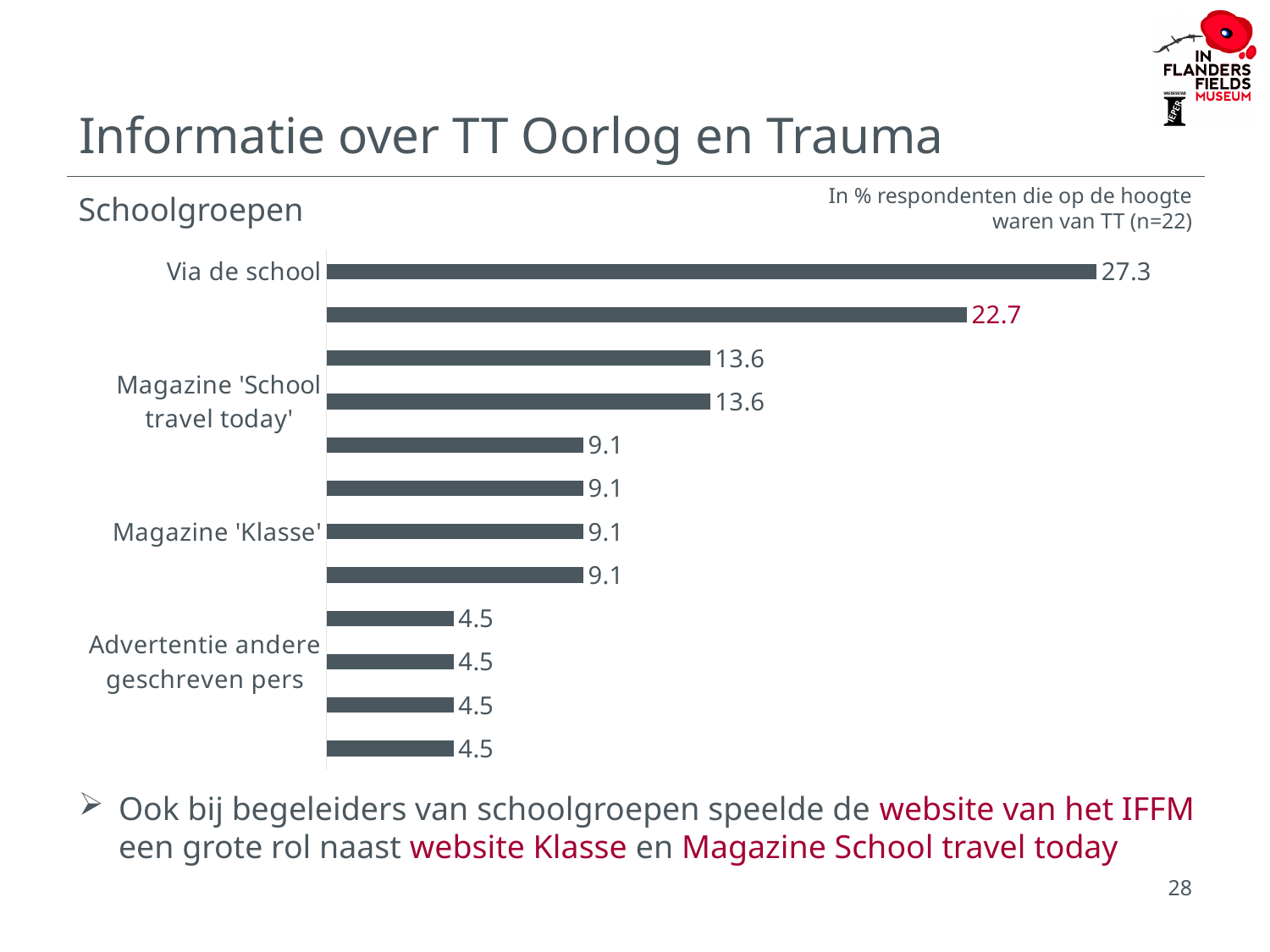
How many bars are plotted in the chart? 12 Which is larger, the value for Magazine 'School travel today' or for 'Advertentie andere geschreven pers'? Magazine 'School travel today' What is the value for Magazine 'Klasse'? 9.1 What is the difference between the values for 'Via de school' and Magazine 'Klasse'? 18.2 What is the value for 'Via de school'? 27.3 How many respondents (n) does the chart note say were aware of TT? 22 What kind of chart is shown on the slide? Bar chart What is the lowest value shown in the chart? 4.5 What is the highest value shown in the chart? 27.3 Which labelled category has the highest value? Via de school What is the value for Magazine 'School travel today'? 13.6 What is the value for 'Advertentie andere geschreven pers'? 4.5